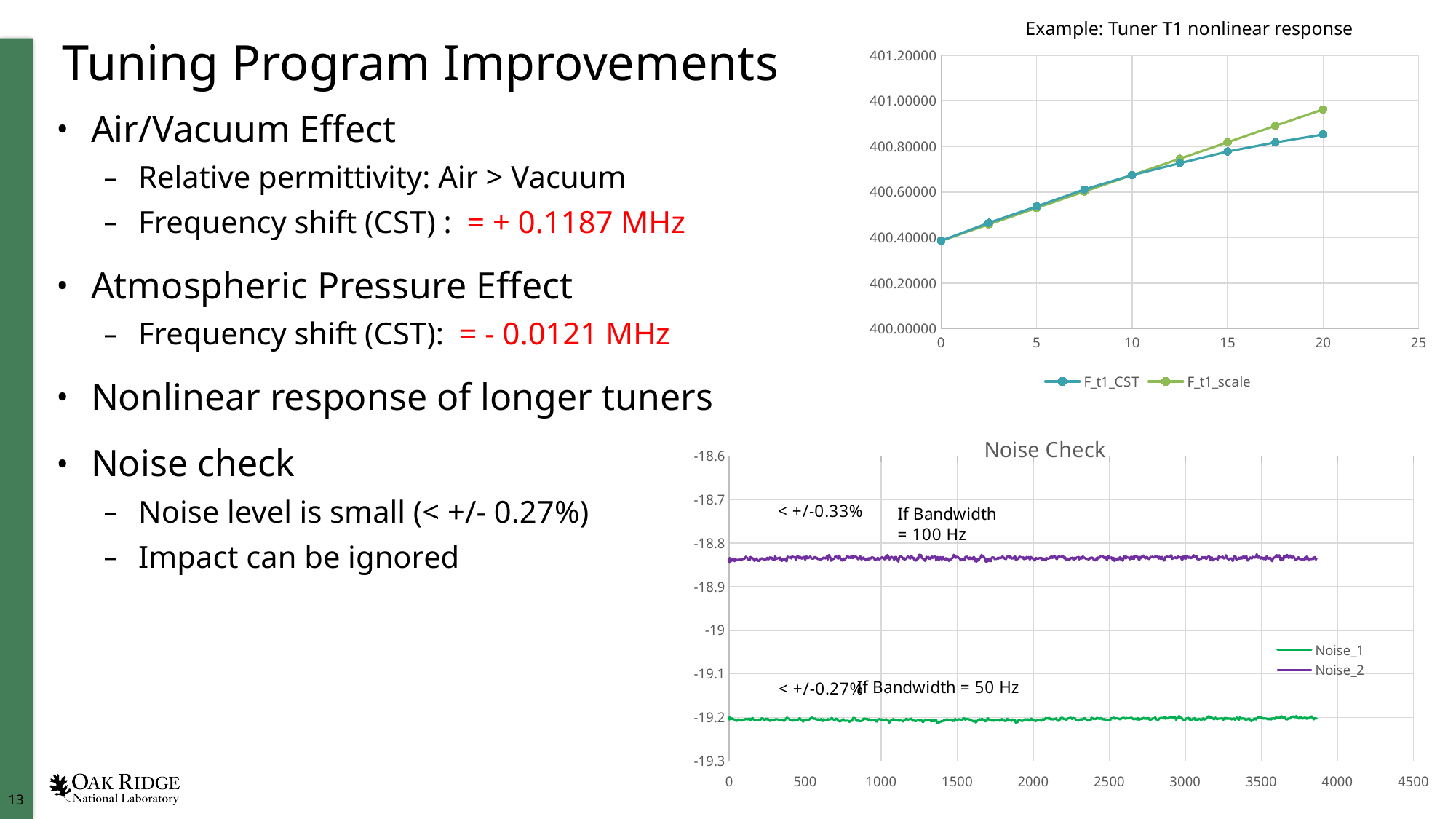
In the 'Noise Check' chart, are the Noise_2 values greater or less than -18.8? less What kind of chart is the 'Example: Tuner T1 nonlinear response' chart? line chart In the 'Example: Tuner T1 nonlinear response' chart, how many data points are plotted for the F_t1_CST series? 9 How many series does the legend of the 'Example: Tuner T1 nonlinear response' chart list? 2 In the 'Example: Tuner T1 nonlinear response' chart, is the F_t1_CST value at x = 10 greater or less than 400.60000? greater What is the title of the lower chart on the slide? Noise Check In the 'Example: Tuner T1 nonlinear response' chart, at x = 20, which series has the higher value, F_t1_CST or F_t1_scale? F_t1_scale In the 'Example: Tuner T1 nonlinear response' chart, do the F_t1_CST values rise or fall as x increases from 0 to 20? rise In the 'Noise Check' chart, are the Noise_1 values greater or less than -19.1? less In the 'Noise Check' chart, which series has the higher values, Noise_1 or Noise_2? Noise_2 How many series does the legend of the 'Noise Check' chart list? 2